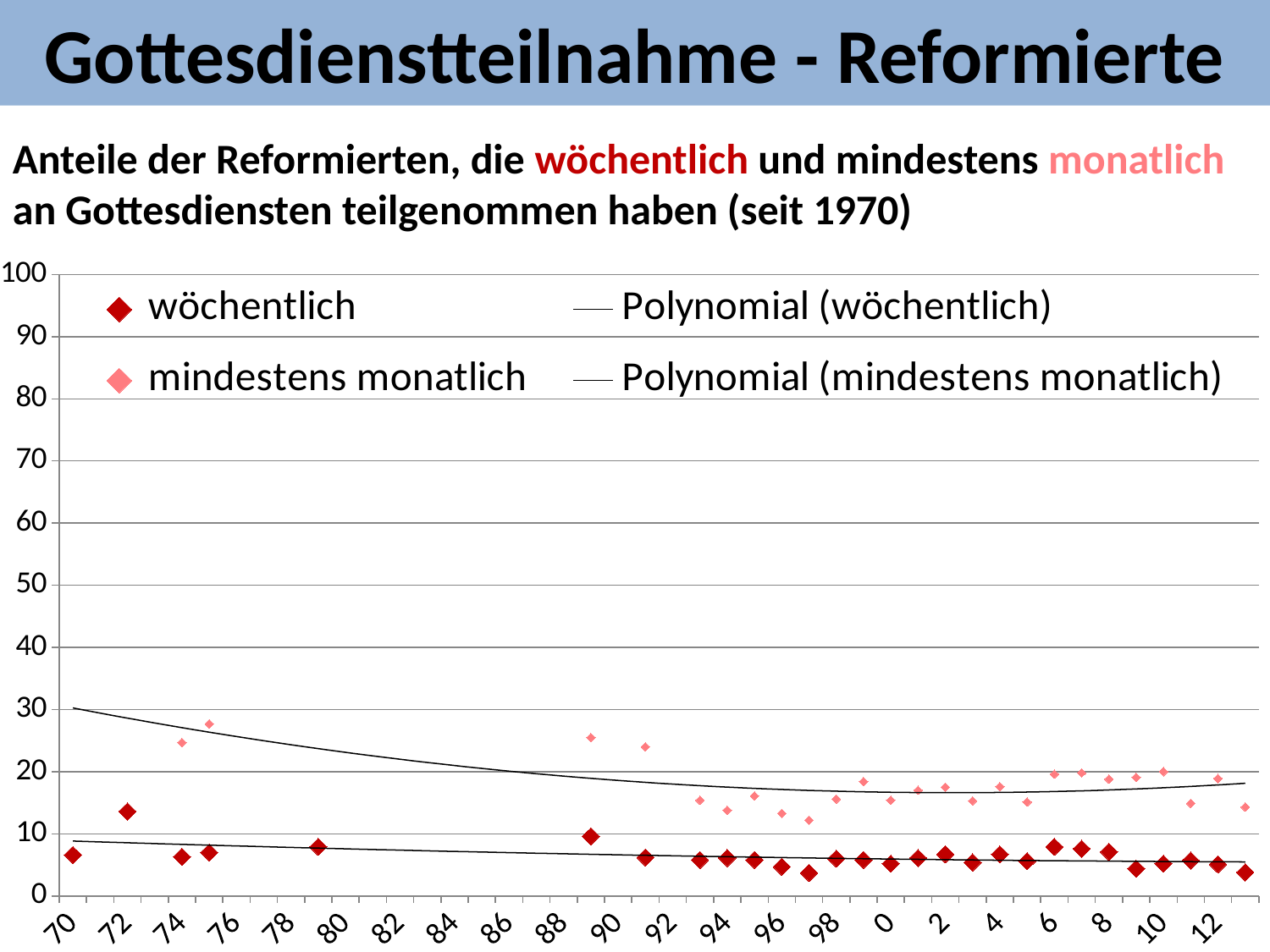
How many entries does the chart legend list? 4 Is the value for mindestens monatlich in 1989 greater or less than 20? greater Is the value for wöchentlich in 1972 greater or less than 10? greater Is the value for mindestens monatlich in 1975 greater or less than 20? greater What is the highest value shown on the vertical axis? 100 What kind of chart is shown on the slide? scatter chart Does the polynomial trendline for mindestens monatlich rise or fall between 1970 and 1990? fall Which colour marks the wöchentlich series in the legend? dark red Which series has the larger value in 1975, wöchentlich or mindestens monatlich? mindestens monatlich